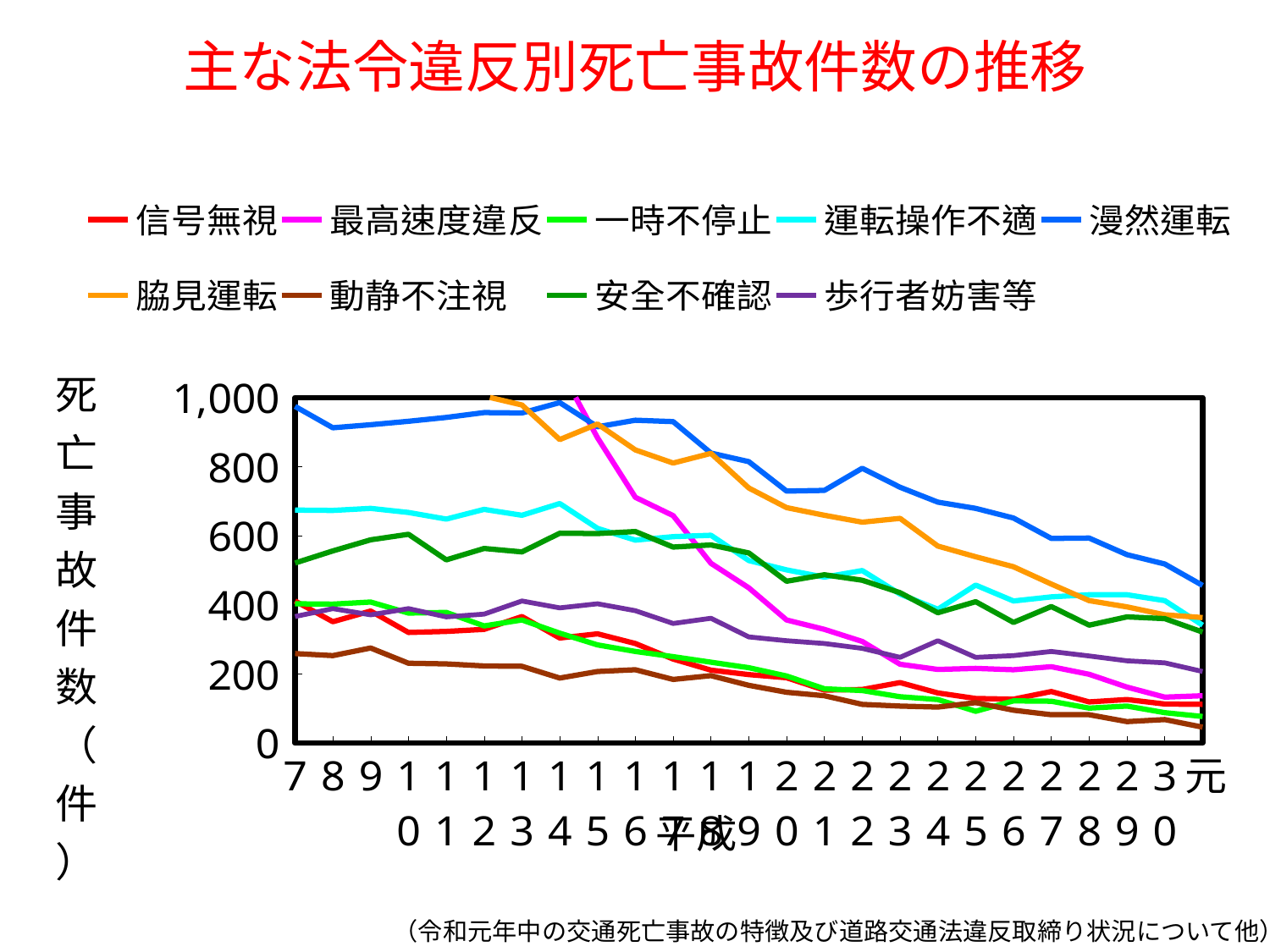
Which series has the lowest value at 平成7 (the first point)? 動静不注視 Does the value for 漫然運転 rise or fall from 平成7 to 令和元? fall What colour is the line for 漫然運転? blue Which series has the highest value at 令和元 (the last point)? 漫然運転 How many points along the x axis does each line cover (平成7 through 令和元)? 25 What kind of chart is shown on the slide? line chart Is the value for 動静不注視 at 平成7 greater or less than 400? less Is the value for 漫然運転 at 平成7 greater or less than 800? greater At 平成7, which is larger: the value for 運転操作不適 or the value for 信号無視? 運転操作不適 How many series does the legend list? 9 What is the title of the chart? 主な法令違反別死亡事故件数の推移 Is the value for 最高速度違反 at 令和元 greater or less than 200? less